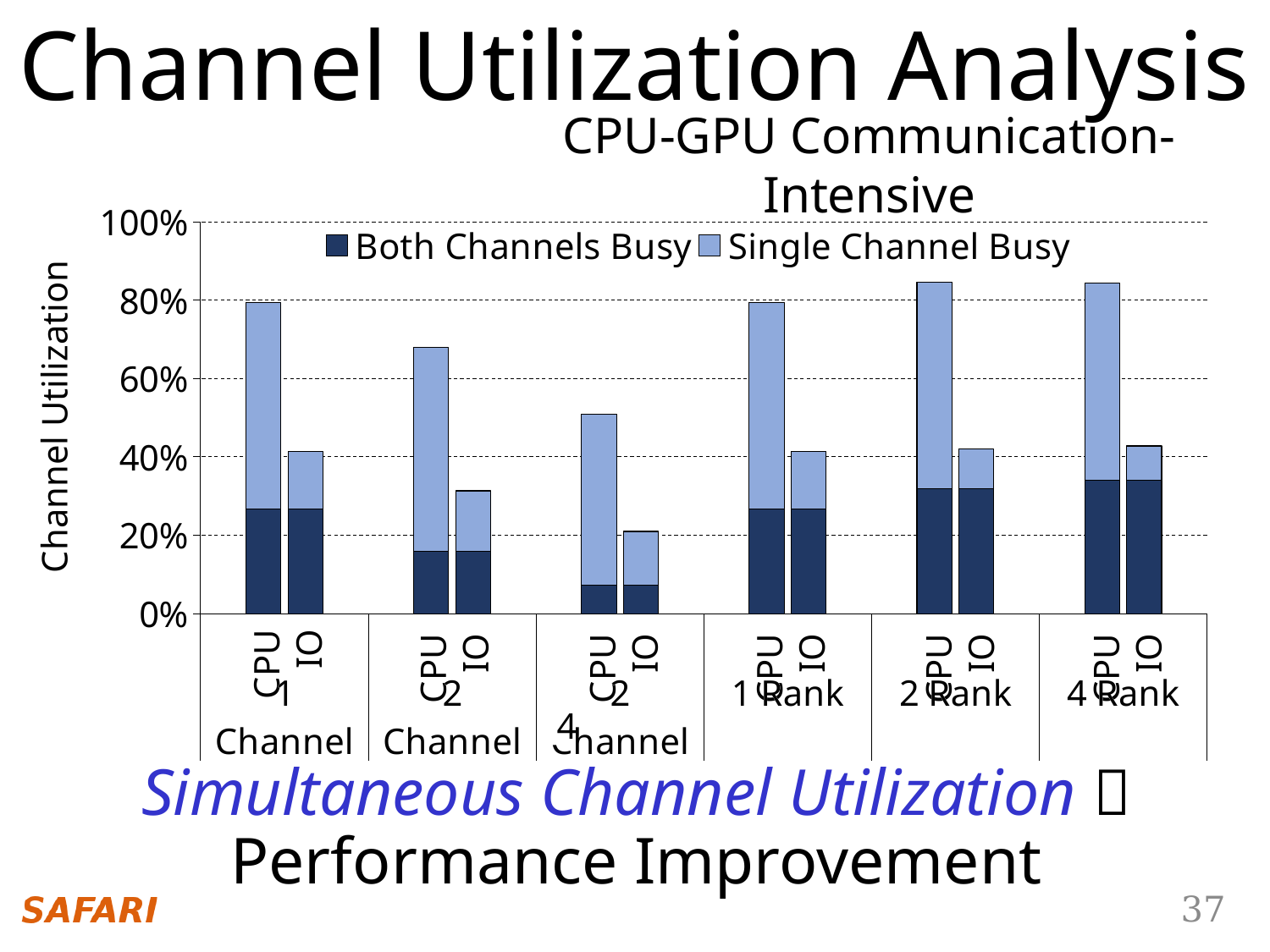
What is the label of the vertical axis? Channel Utilization Is the total channel utilization for the CPU bar in the 4 Channel group greater or less than 40%? greater In the 1 Channel group, which bar has the higher total channel utilization, CPU or IO? CPU Is the total channel utilization for the CPU bar in the 1 Channel group greater or less than 60%? greater What kind of chart is shown on the slide? Stacked bar chart How many configuration groups (e.g. 1 Channel, 2 Channel, ...) are shown along the x axis? 6 Which bar has the lowest total channel utilization in the chart? IO in the 4 Channel group Is the total channel utilization for the CPU bar in the 2 Rank group greater or less than 80%? greater How many series does the legend list? 2 What are the two series named in the legend? Both Channels Busy, Single Channel Busy